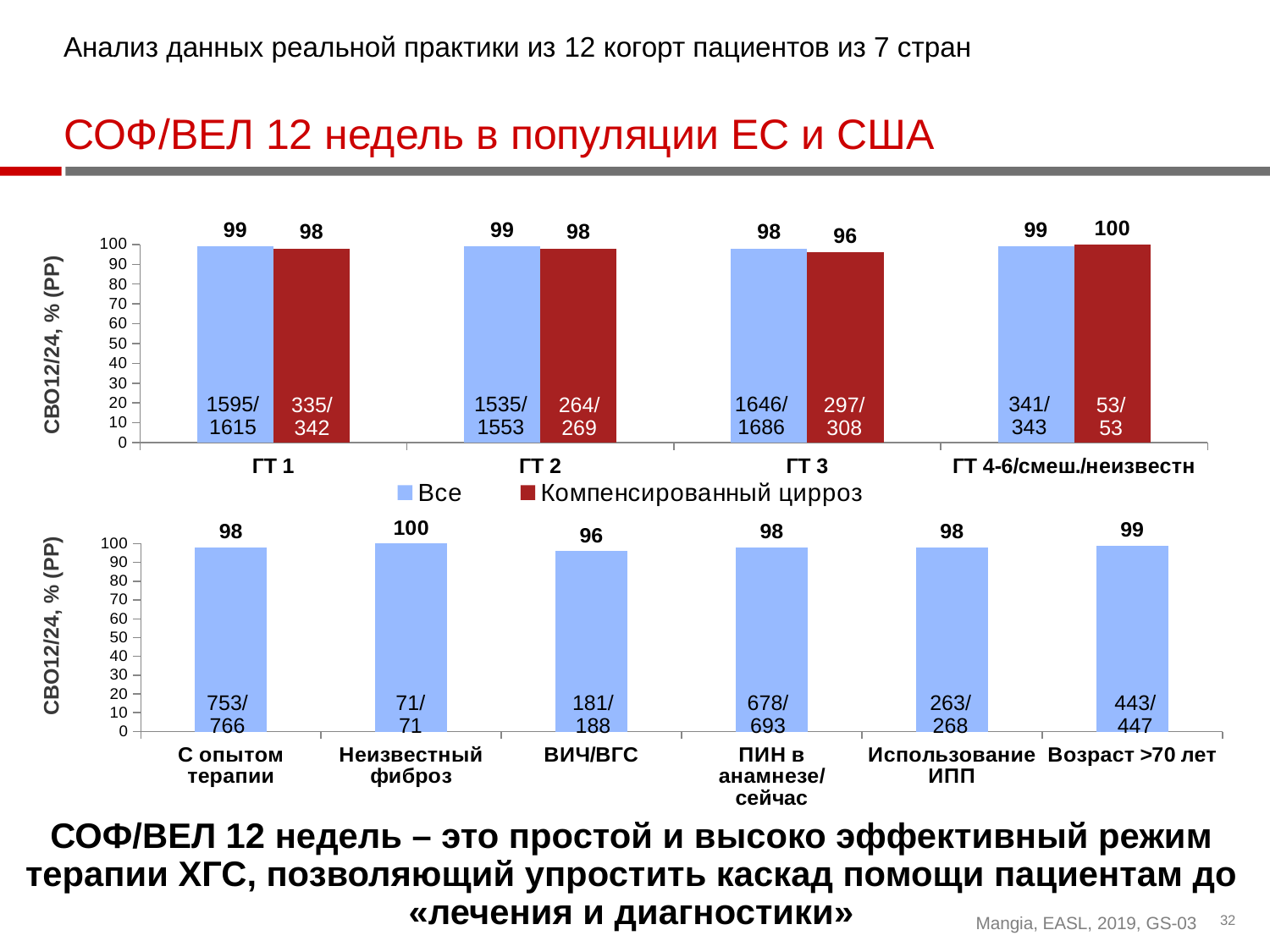
In the top chart, what is the difference between the Все and Компенсированный цирроз values for ГТ 3? 2 In the top chart, which category has the highest value in the Компенсированный цирроз series? ГТ 4-6/смеш./неизвестн In the bottom chart, what is the value for ВИЧ/ВГС? 96 How many series does the legend of the top chart list? 2 How many categories are shown on the x axis of the bottom chart? 6 In the top chart, what is the value for ГТ 3 in the Компенсированный цирроз series? 96 How many categories are shown on the x axis of the top chart? 4 In the top chart, which category has the lowest value in the Компенсированный цирроз series? ГТ 3 In the bottom chart, which category has the highest value? Неизвестный фиброз In the top chart, what is the value for ГТ 1 in the Все series? 99 In the bottom chart, which category has the lowest value? ВИЧ/ВГС What type of chart is the bottom chart? Bar chart